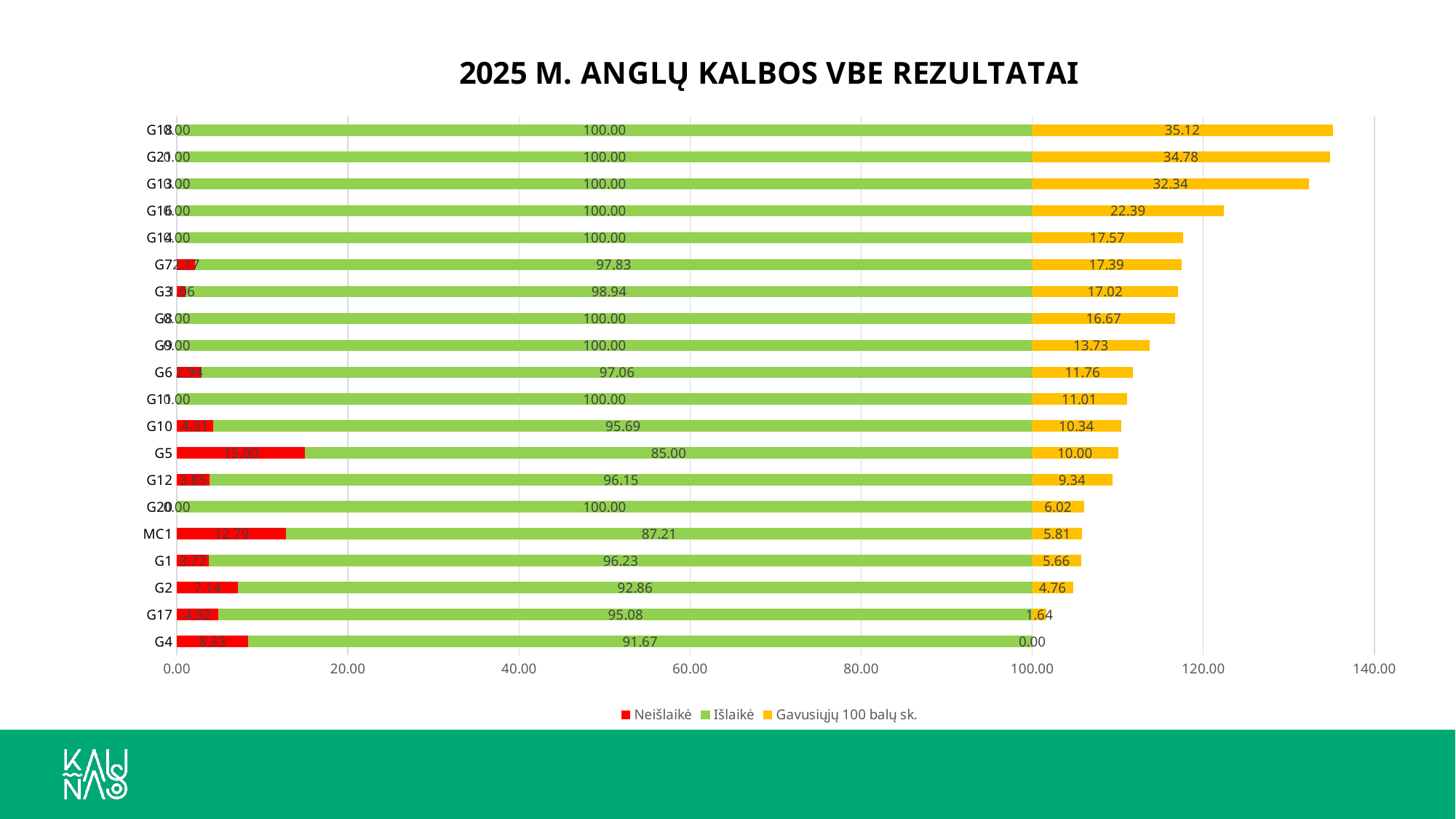
Which category has the highest Gavusiųjų 100 balų sk. value? G18 What is the Neišlaikė value for G5? 15.00 How many categories (schools) are plotted on the chart? 20 What kind of chart is shown on the slide? bar chart How many series does the legend list? 3 Which category has the lowest Gavusiųjų 100 balų sk. value? G4 What is the total of the stacked bar for G5? 110.00 Which category has the highest Neišlaikė value? G5 What is the Gavusiųjų 100 balų sk. value for G16? 22.39 What is the difference between the Gavusiųjų 100 balų sk. values of G18 and G21? 0.34 Which has the larger Išlaikė value, G5 or MC1? MC1 What is the title of the chart? 2025 M. ANGLŲ KALBOS VBE REZULTATAI